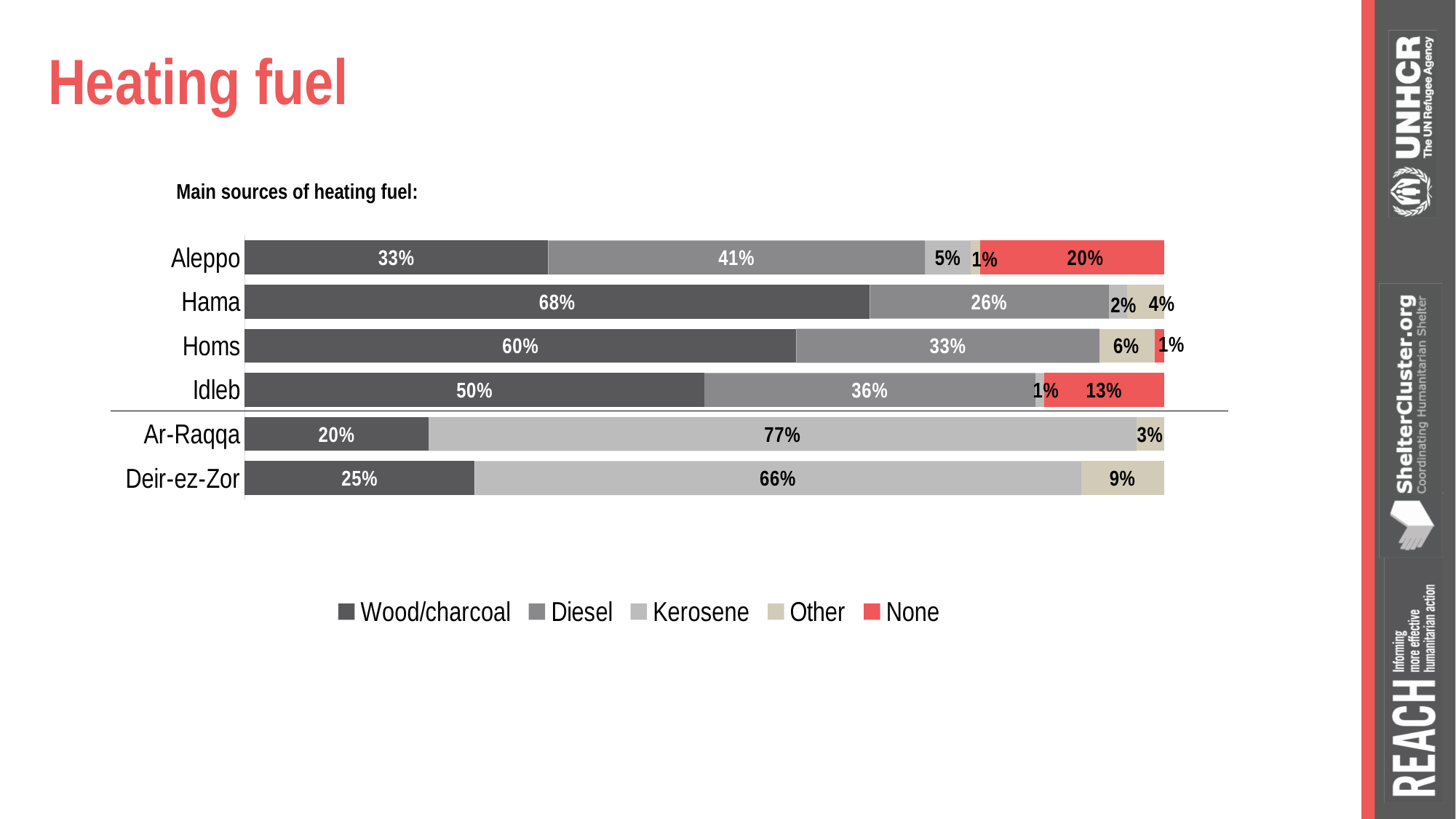
How many series does the legend list? 5 What is the Wood/charcoal share for Hama? 68% Which governorate has the highest Wood/charcoal share? Hama How many percentage points higher is the Wood/charcoal share in Hama than in Aleppo? 35 percentage points How many governorates (categories) are shown in the chart? 6 What percentage of households in Aleppo reported 'None' as their heating fuel? 20% What is the Kerosene share for Ar-Raqqa? 77% What is the 'Other' share for Deir-ez-Zor? 9% Which governorate has the lowest Wood/charcoal share? Ar-Raqqa What colour represents the 'None' series in the legend? Red Which has a larger 'None' share, Aleppo or Idleb? Aleppo What kind of chart is shown on the slide? Stacked bar chart